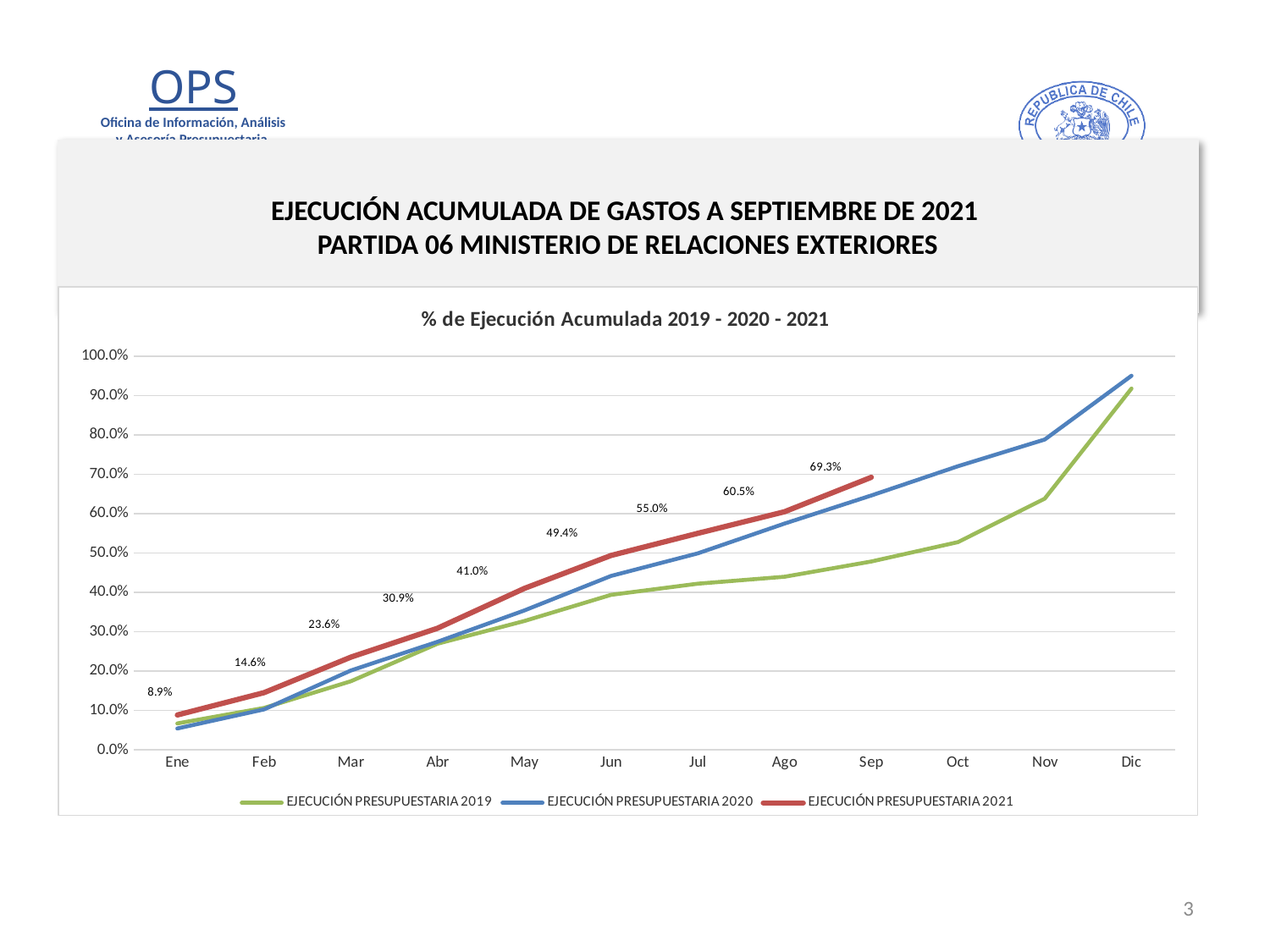
Do the values for EJECUCIÓN PRESUPUESTARIA 2021 rise or fall from Ene to Sep? Rise How many series does the legend list? 3 What is the difference between the EJECUCIÓN PRESUPUESTARIA 2021 values for Sep and Ago? 8.8% What is the value for EJECUCIÓN PRESUPUESTARIA 2021 in Ene? 8.9% What is the value for EJECUCIÓN PRESUPUESTARIA 2021 in Sep? 69.3% Is the value for EJECUCIÓN PRESUPUESTARIA 2019 in Oct greater or less than 60.0%? less Is the value for EJECUCIÓN PRESUPUESTARIA 2020 in Dic greater or less than 90.0%? greater Which series has the higher value in Ago, EJECUCIÓN PRESUPUESTARIA 2019 or EJECUCIÓN PRESUPUESTARIA 2021? EJECUCIÓN PRESUPUESTARIA 2021 What is the difference between the EJECUCIÓN PRESUPUESTARIA 2021 values for Mar and Feb? 9.0% What is the value for EJECUCIÓN PRESUPUESTARIA 2021 in May? 41.0% What is the value for EJECUCIÓN PRESUPUESTARIA 2021 in Jul? 55.0% What kind of chart is shown on the slide? Line chart